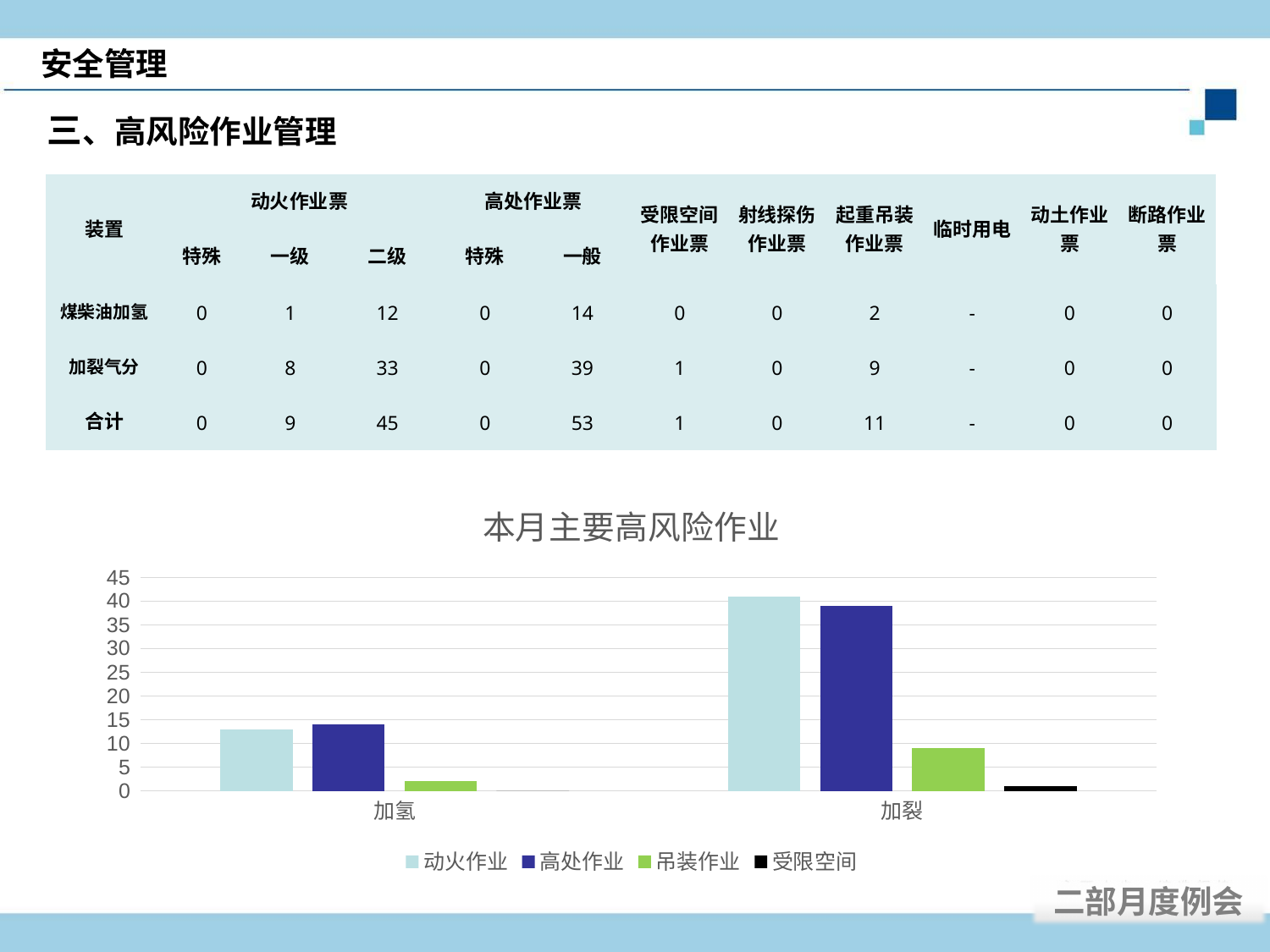
Is the value for 动火作业 in the 加裂 category greater or less than 35? greater Which category has the larger value for 动火作业, 加氢 or 加裂? 加裂 What kind of chart is shown on the slide? bar chart Is the value for 高处作业 in the 加氢 category greater or less than 20? less Is the value for 吊装作业 in the 加氢 category greater or less than 5? less Which category has the larger value for 吊装作业, 加氢 or 加裂? 加裂 How many categories are shown on the x axis of the chart? 2 How many series does the chart legend list? 4 Which series has the lowest value in the 加氢 category? 受限空间 Which series has the lowest value in the 加裂 category? 受限空间 What is the title of the chart? 本月主要高风险作业